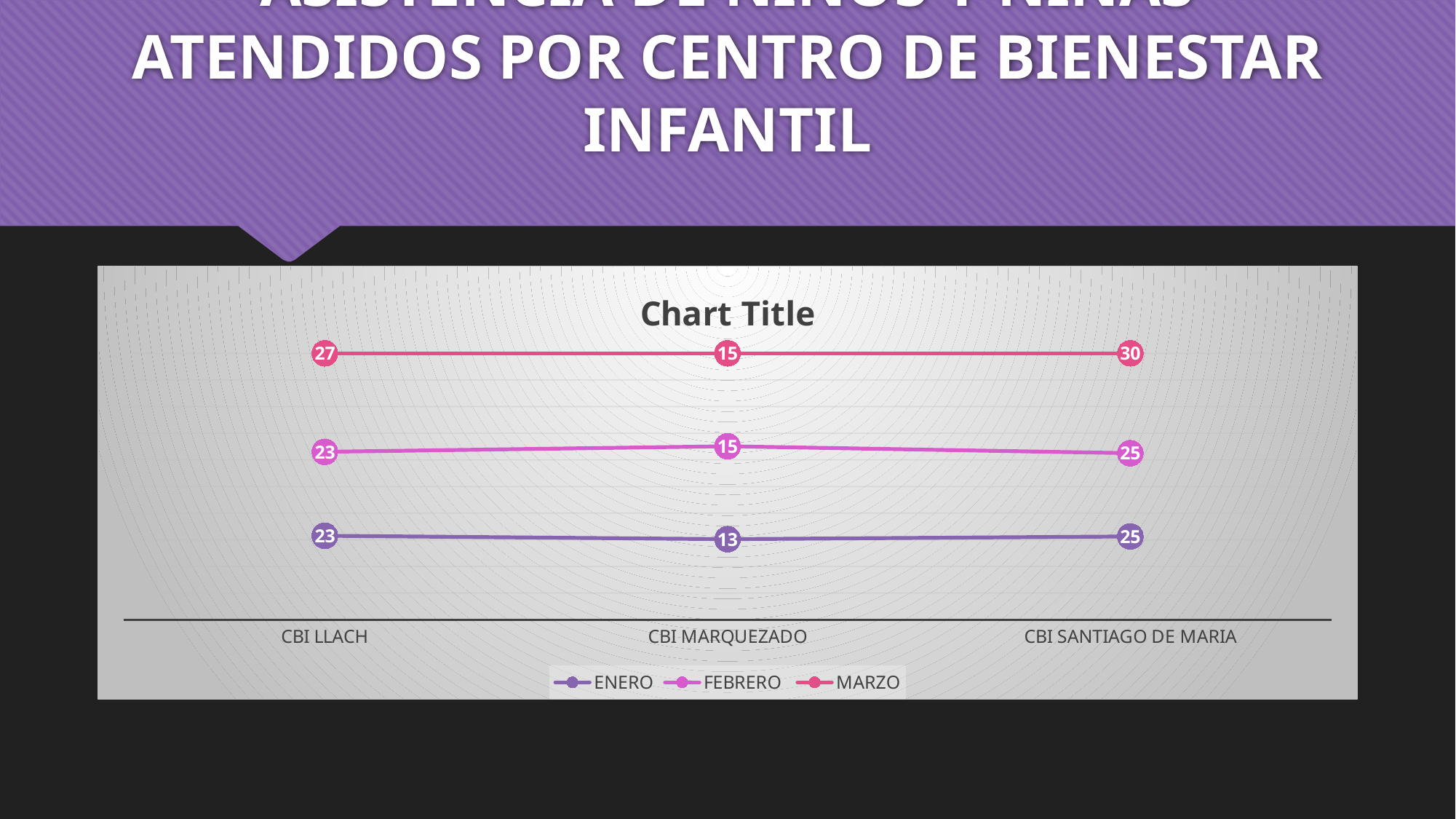
Which category has the highest value for the MARZO series? CBI SANTIAGO DE MARIA What is the value for ENERO at CBI MARQUEZADO? 13 What is the value for FEBRERO at CBI LLACH? 23 What is the value for MARZO at CBI SANTIAGO DE MARIA? 30 What is the title printed on the chart? Chart Title How many categories are shown on the x axis? 3 What type of chart is shown on the slide? line chart How many series does the legend list? 3 What is the difference between the MARZO and ENERO values at CBI SANTIAGO DE MARIA? 5 Which category has the lowest value for the ENERO series? CBI MARQUEZADO Which is larger at CBI LLACH, the MARZO value or the FEBRERO value? MARZO What is the value for MARZO at CBI LLACH? 27